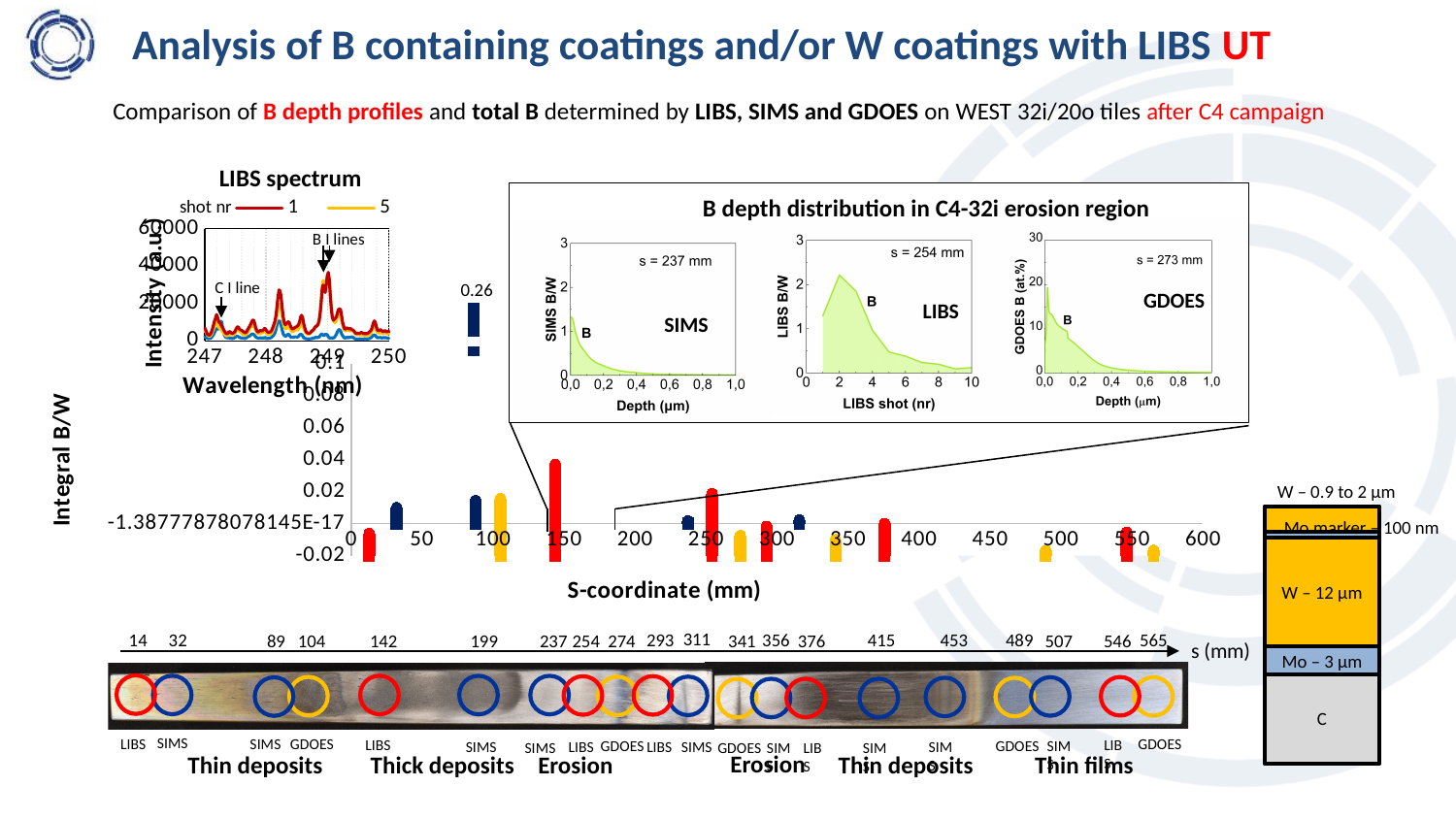
What value is printed as a data label on the tall bar near s = 100 mm in the main bar chart? 0.26 In the GDOES panel of the inset, is the peak GDOES B value greater or less than 10? greater What is the highest tick value on the x axis of the main bar chart? 600 In the SIMS panel of the inset, is the peak SIMS B/W value greater or less than 2? less What kind of chart is the main chart with the x axis 'S-coordinate (mm)'? bar chart In the LIBS panel of the inset, is the peak LIBS B/W value greater or less than 1? greater In the SIMS panel of the inset, do the values rise or fall as depth increases? fall What is the x-axis title of the LIBS panel in the inset? LIBS shot (nr) What is the highest tick value on the y axis of the 'LIBS spectrum' chart? 60000 What is the title of the inset chart group in the upper right? B depth distribution in C4-32i erosion region How many series does the legend of the 'LIBS spectrum' chart list? 2 How many panels make up the 'B depth distribution in C4-32i erosion region' inset? 3